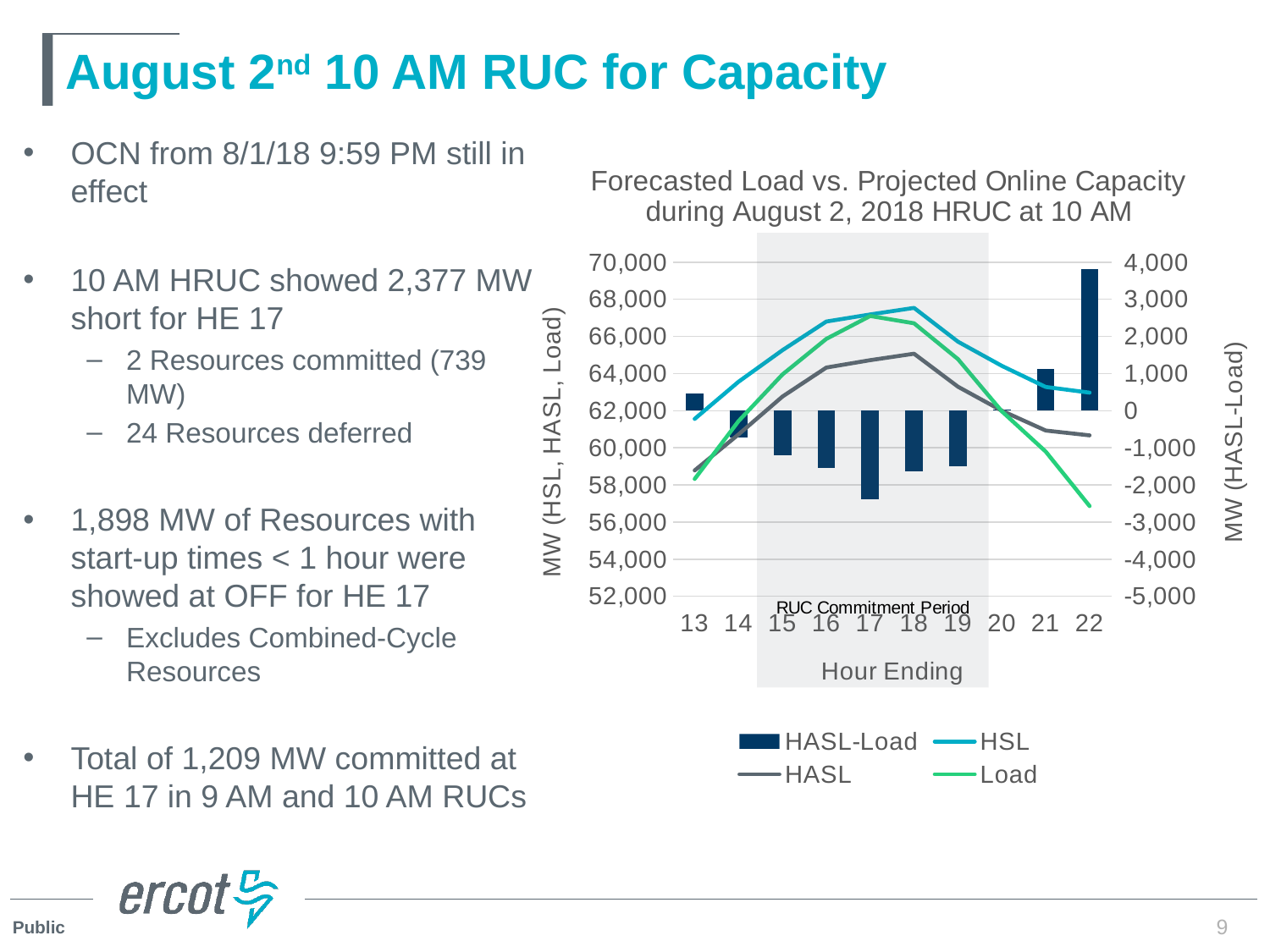
Is the HASL-Load value for Hour Ending 17 greater or less than -2,000? less Does the Load line rise or fall from Hour Ending 18 to Hour Ending 22? fall At which Hour Ending is the HASL-Load bar lowest? 17 What kind of chart is shown on the slide? Combination bar and line chart At which Hour Ending is the HASL-Load bar highest? 22 How many Hour Ending categories are shown on the x axis of the chart? 10 Is the HASL-Load value for Hour Ending 22 greater or less than 3,000? greater Which is higher at Hour Ending 22, HSL or Load? HSL Is the Load value for Hour Ending 22 greater or less than 58,000? less Which series in the chart is plotted as bars? HASL-Load What is the title of the chart? Forecasted Load vs. Projected Online Capacity during August 2, 2018 HRUC at 10 AM How many series does the chart legend list? 4